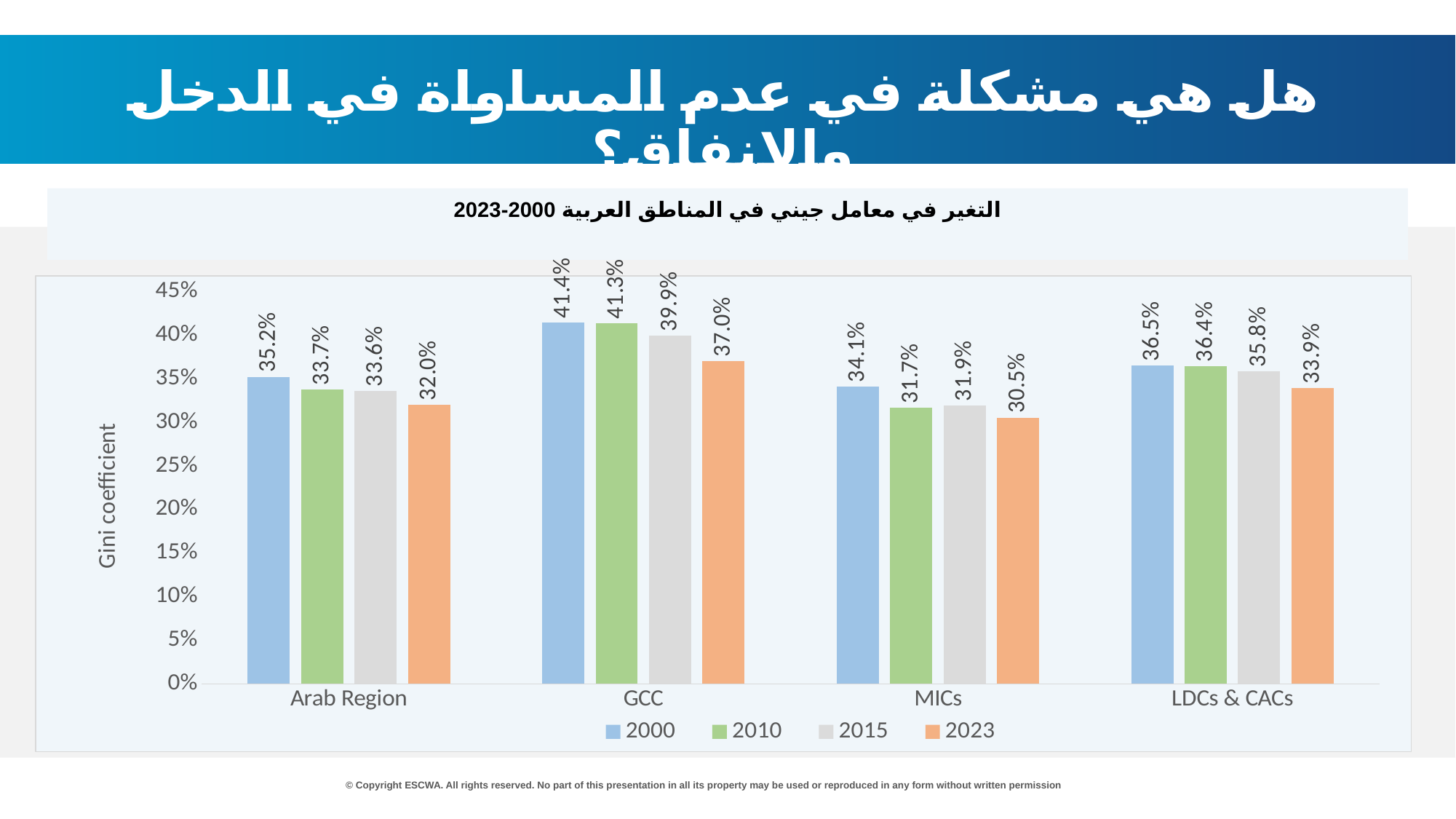
Which region has the highest Gini coefficient in 2023? GCC What kind of chart is shown on the slide? Bar chart What is the Gini coefficient for the Arab Region in 2010? 33.7% What is the Gini coefficient for LDCs & CACs in 2015? 35.8% Which is larger: the Gini coefficient for MICs in 2010 or for LDCs & CACs in 2010? LDCs & CACs in 2010 How many series does the legend list? 4 Which region has the lowest Gini coefficient in 2000? MICs What is the Gini coefficient for GCC in 2000? 41.4% What is the Gini coefficient for MICs in 2023? 30.5% What is the difference between the Arab Region's Gini coefficient in 2000 and in 2023? 3.2% How many regions are shown on the x axis of the chart? 4 What is the label of the vertical axis? Gini coefficient